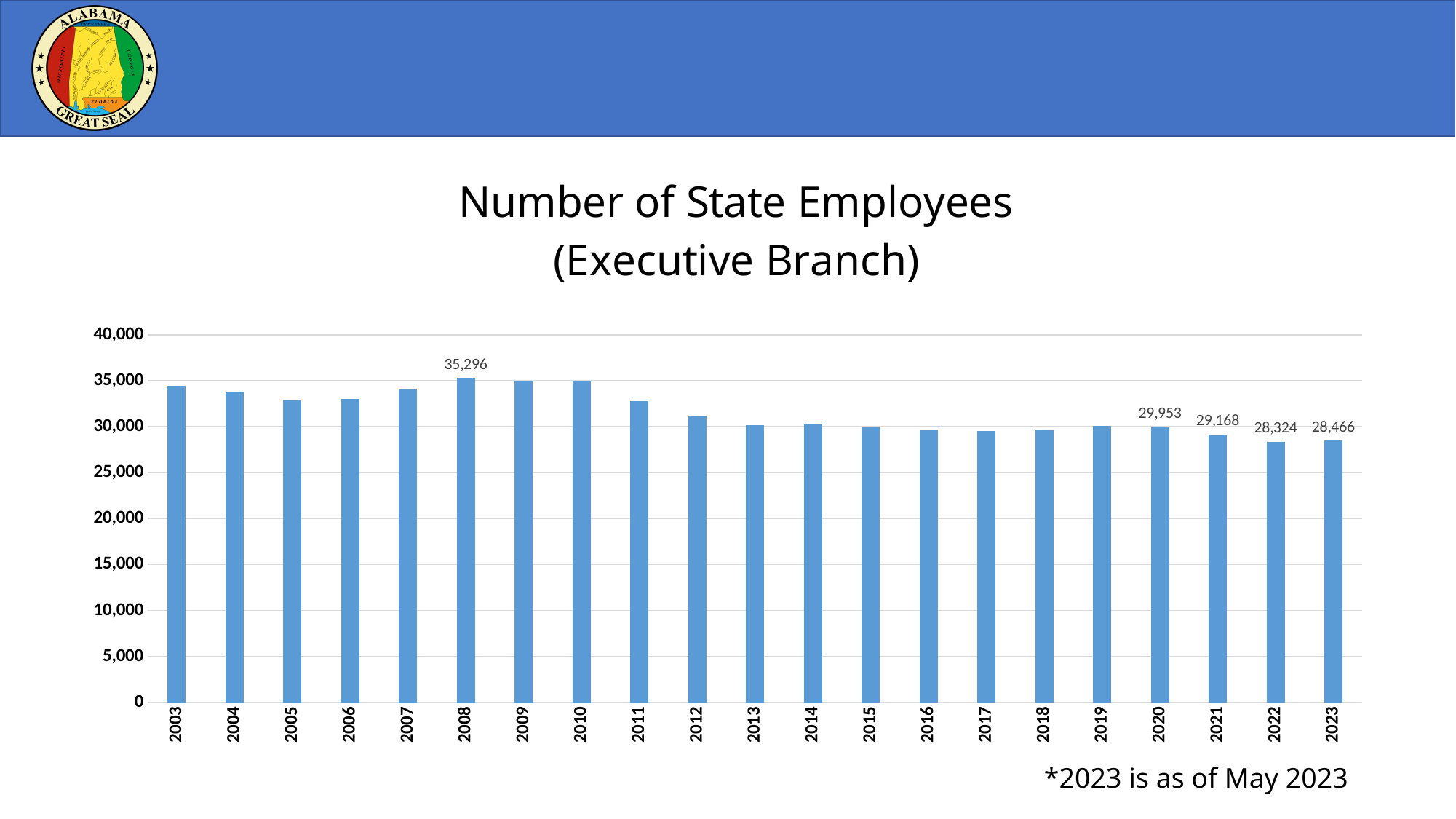
Is the value for 2011 greater or less than 30,000? greater What is the value for 2008? 35,296 Which year has the highest number of state employees? 2008 What is the value for 2023? 28,466 What is the value for 2021? 29,168 Which is larger, the value for 2022 or the value for 2023? 2023 Overall, do the values rise or fall from 2003 to 2023? fall Which year has the lowest number of state employees? 2022 How many years are shown on the x axis? 21 What is the difference between the values for 2020 and 2021? 785 What is the difference between the values for 2008 and 2023? 6,830 What kind of chart is shown on the slide? bar chart